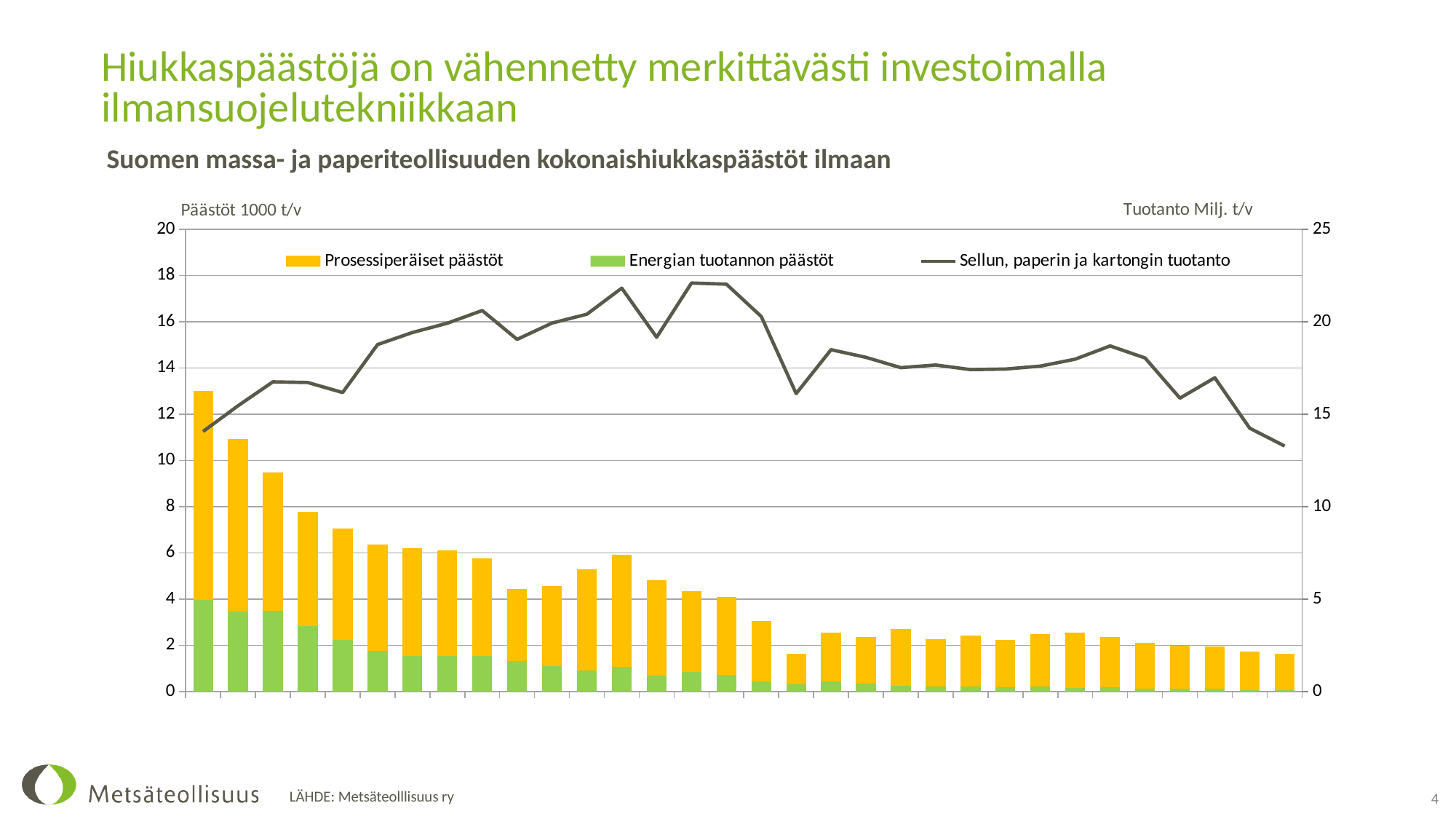
Is the total of the rightmost stacked bar greater or less than 2 on the left axis? less Which series is drawn as a line rather than bars? Sellun, paperin ja kartongin tuotanto Which stacked bar is the highest in the chart? The leftmost bar Is the highest point of the Sellun, paperin ja kartongin tuotanto line greater or less than 20 on the right axis? greater Is the total of the leftmost stacked bar greater or less than 12 on the left axis? greater What is the title of the left vertical axis? Päästöt 1000 t/v Do the stacked emission bars generally rise or fall from left to right along the x axis? Fall How many series does the chart legend list? 3 Which is larger, the Energian tuotannon päästöt segment of the leftmost bar or that of the rightmost bar? The leftmost bar What kind of chart is shown on the slide? A combined bar and line chart Which is larger, the leftmost stacked bar or the second bar from the left? The leftmost bar